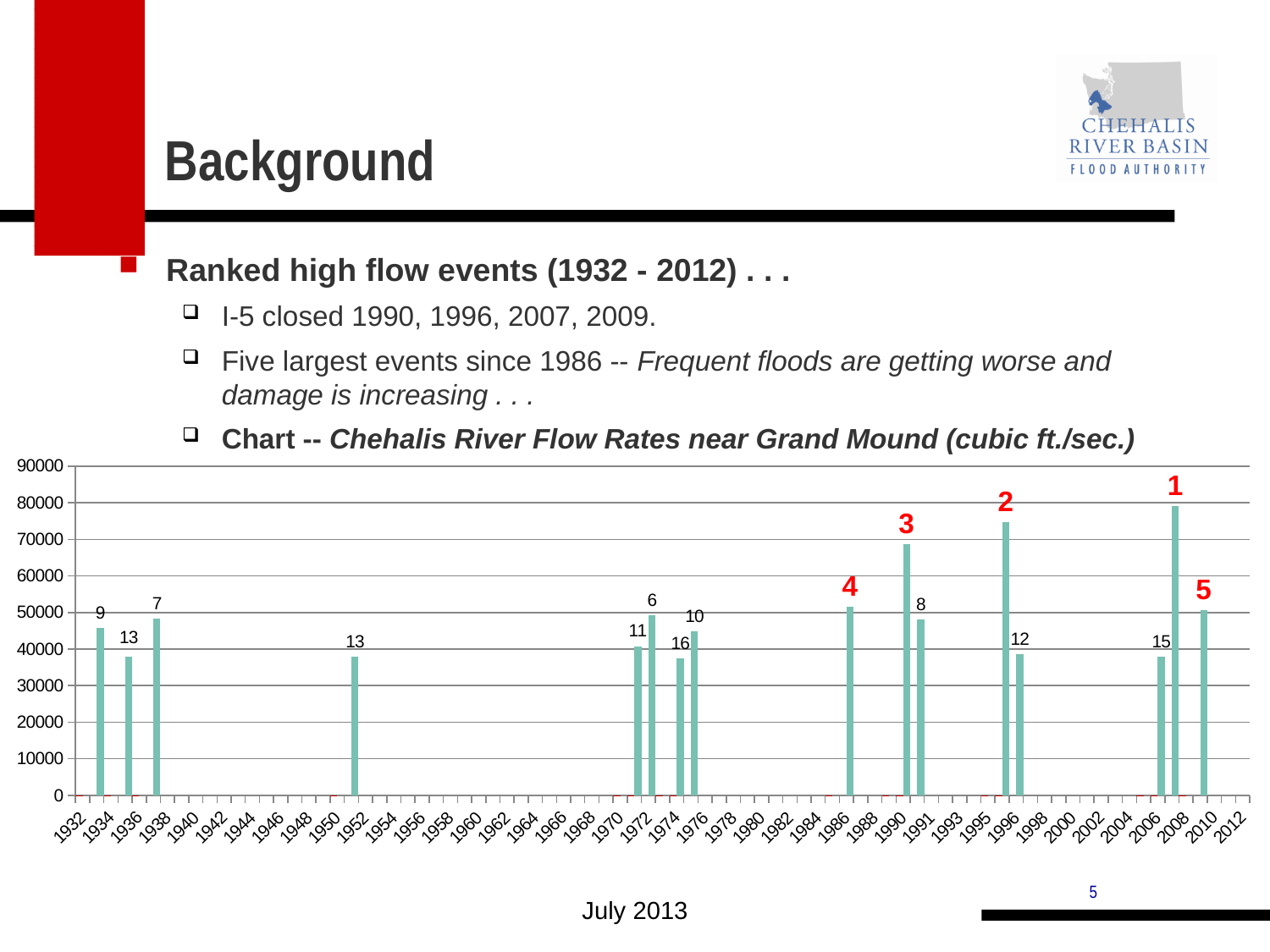
Which year has the highest flow rate in the chart? 2007 What rank label is printed above the bar for 1990? 3 Is the flow rate for 1933 greater or less than 50000? less Is the flow rate for 2007 greater or less than 70000? greater Which has the larger flow rate, 2007 or 1996? 2007 Is the flow rate for 2009 greater or less than 40000? greater How many bars with rank labels are plotted in the chart? 16 What kind of chart is shown on the slide? bar chart